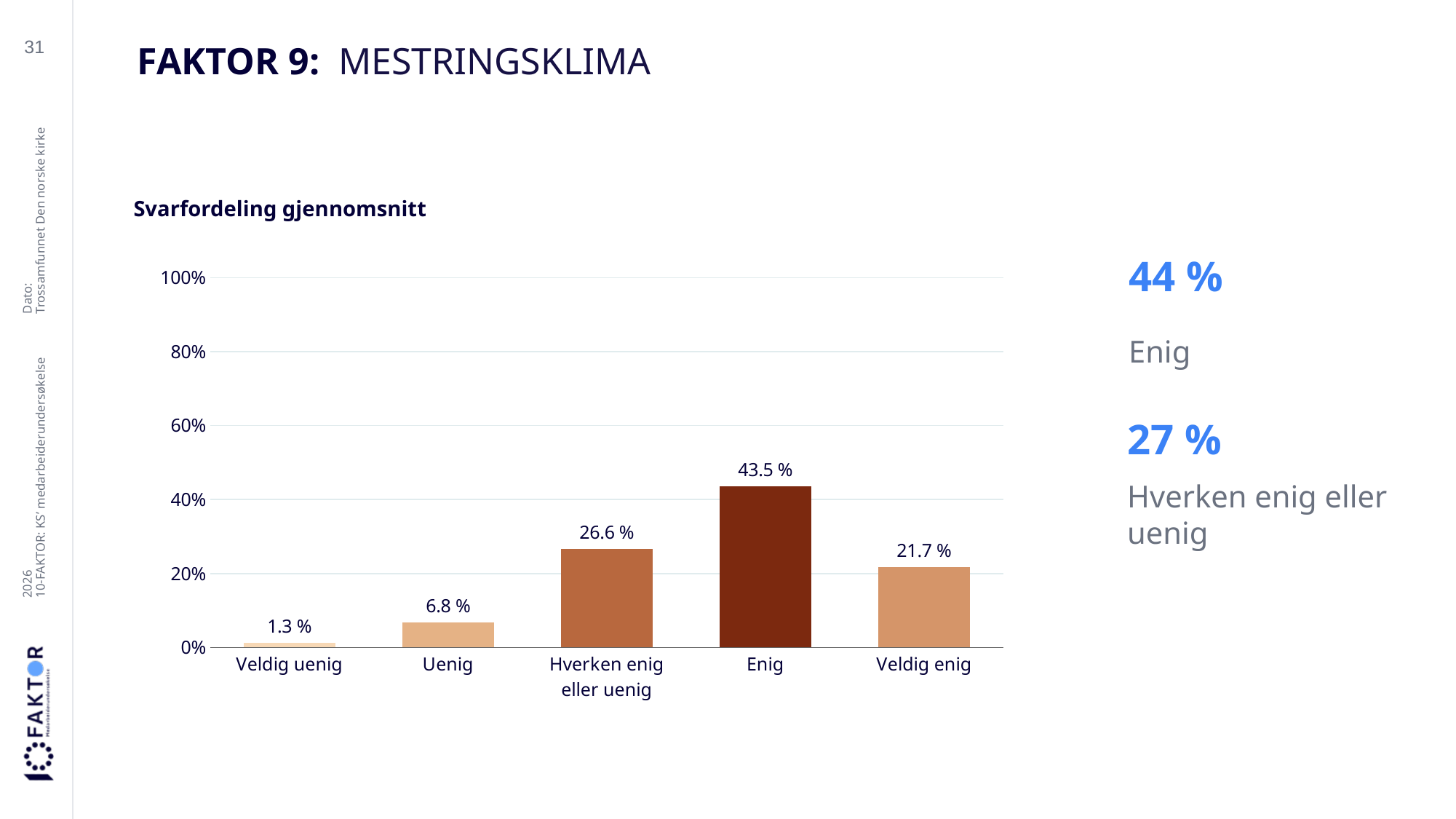
What is the value for Veldig uenig? 1.3 % Which category has the lowest value? Veldig uenig What is the value for Veldig enig? 21.7 % What is the title of the chart? Svarfordeling gjennomsnitt What kind of chart is shown on the slide? bar chart Is the value for Enig greater or less than 40%? greater Which category has the highest value? Enig What is the value for Enig? 43.5 % How many categories are shown on the x axis? 5 Which is larger, the value for Uenig or the value for Veldig enig? Veldig enig What is the difference between the values for Enig and Veldig enig? 21.8 % What is the value for Hverken enig eller uenig? 26.6 %